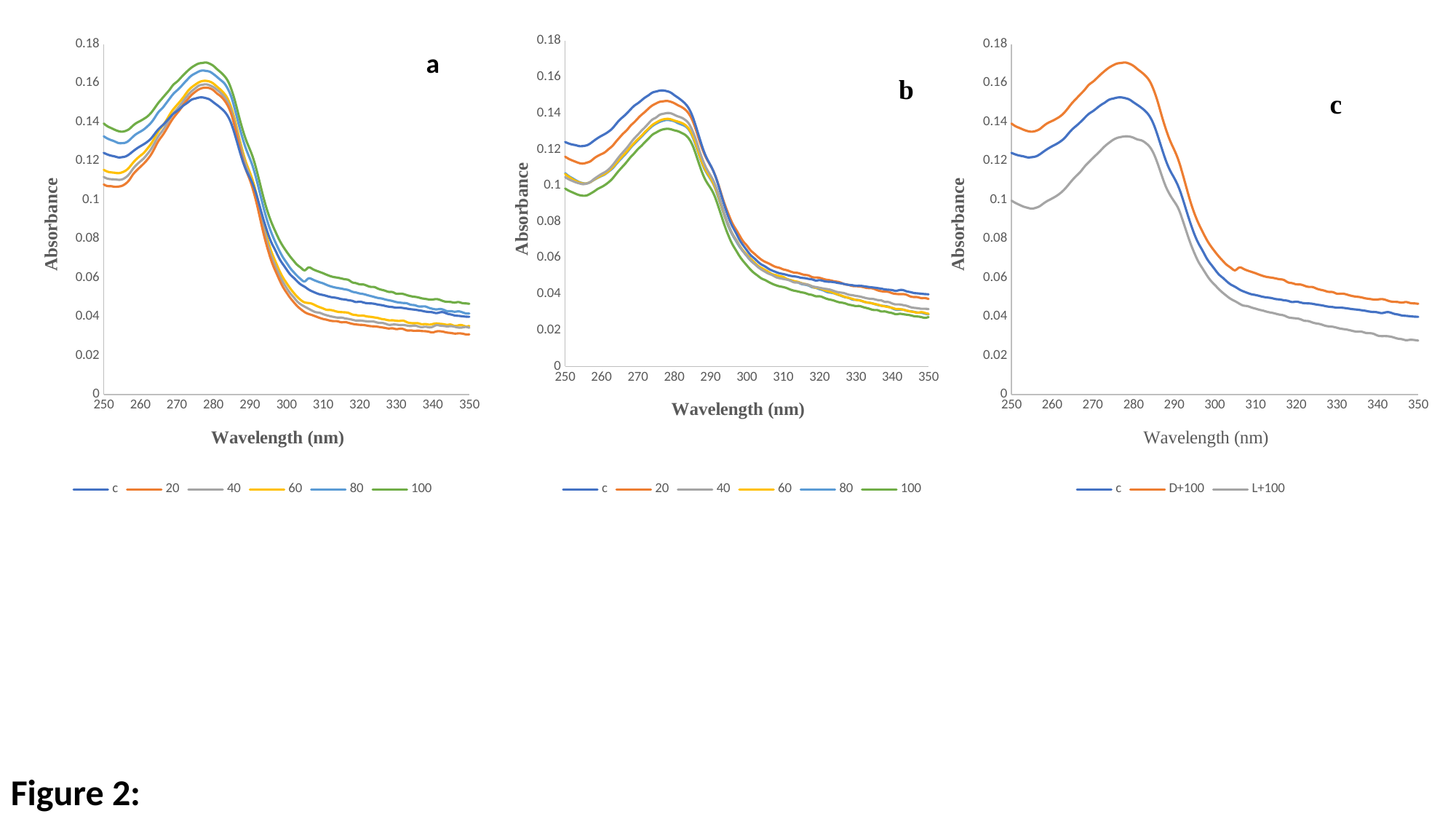
In chart c, is the peak absorbance of the D+100 series greater or less than 0.16? greater In chart a, is the absorbance of the 100 series at 350 nm greater or less than 0.04? greater In chart a, which series reaches the highest peak absorbance? 100 What is the x-axis title of chart b? Wavelength (nm) In chart c, is the absorbance of the L+100 series at 350 nm greater or less than 0.04? less In chart c, do the absorbance values rise or fall between 280 nm and 350 nm? fall What kind of chart is chart a? line chart In chart b, which series reaches the highest peak absorbance? c In chart b, which series has the lowest peak absorbance? 100 How many series does the legend of chart a list? 6 How many series does the legend of chart c list? 3 In chart c, which series has the lowest peak absorbance? L+100